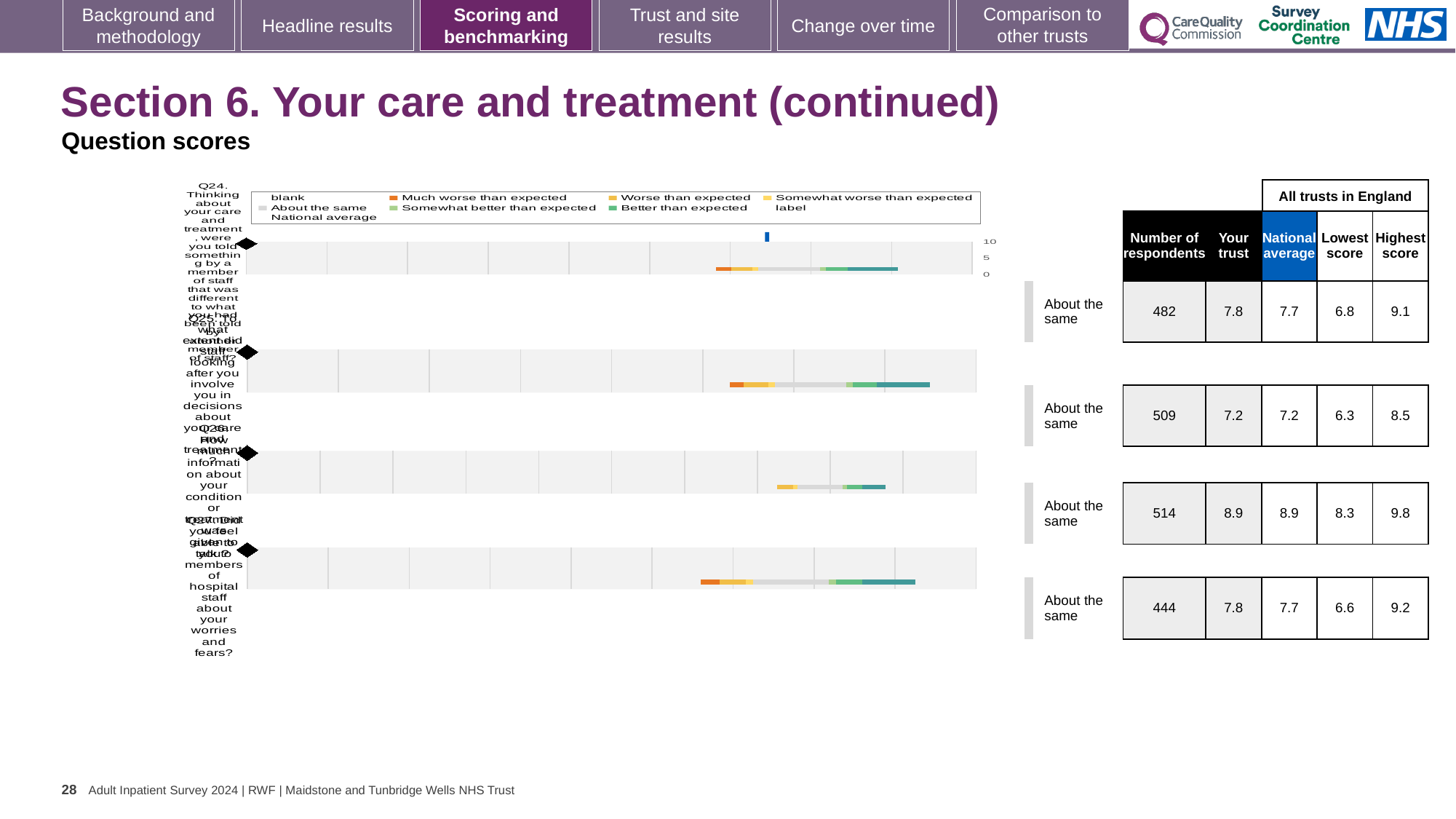
What benchmark category is shown for all four question rows? About the same Which question row has the highest 'Your trust' score? Q26 For the first row (Q24), which is larger: the 'Your trust' score or the national average? Your trust Which legend entry is shown in dark teal/green in the chart legend? Better than expected For the first row (Q24), what is the 'Your trust' score shown in the table next to the chart? 7.8 For the fourth row (Q27), what is the highest score among all trusts in England? 9.2 For the second row (Q25), what is the national average score shown in the table? 7.2 For the third row (Q26), what is the difference between the highest score (9.8) and the lowest score (8.3)? 1.5 Which question row has the lowest 'Your trust' score? Q25 How many questions (rows) are plotted in the question scores chart? 4 What kind of chart is used to show the question scores on the left of the slide? bar chart For the third row (Q26), how many respondents are shown in the table? 514